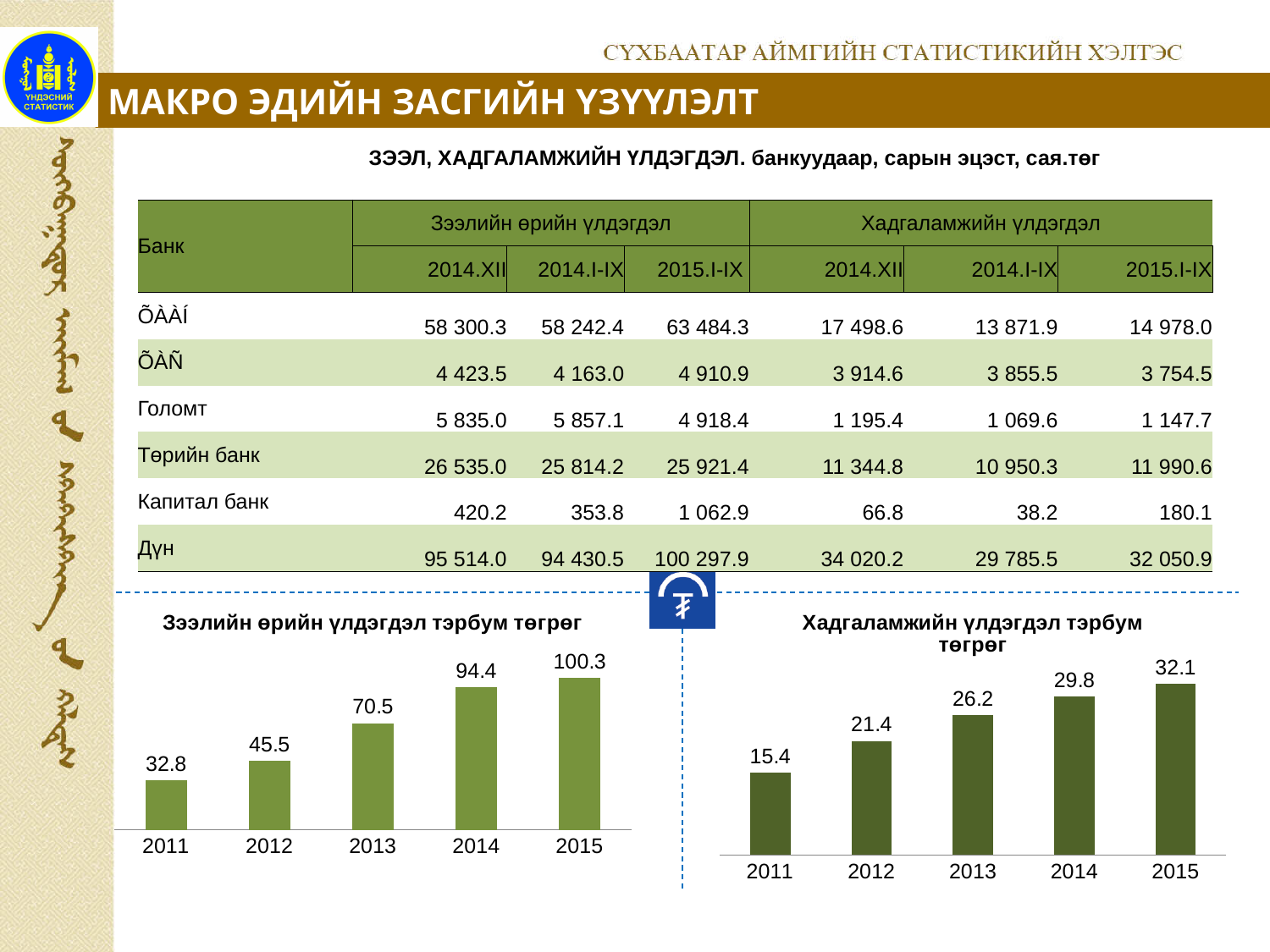
In the left chart titled "Зээлийн өрийн үлдэгдэл тэрбум төгрөг", which is larger, the value for 2012 or the value for 2013? 2013 In the left chart titled "Зээлийн өрийн үлдэгдэл тэрбум төгрөг", what is the difference between the values for 2015 and 2014? 5.9 In the left chart titled "Зээлийн өрийн үлдэгдэл тэрбум төгрөг", which year has the highest value? 2015 In the right chart titled "Хадгаламжийн үлдэгдэл тэрбум төгрөг", what is the value for 2014? 29.8 In the left chart titled "Зээлийн өрийн үлдэгдэл тэрбум төгрөг", what is the value for 2011? 32.8 How many years are shown on the x axis of the right chart titled "Хадгаламжийн үлдэгдэл тэрбум төгрөг"? 5 In the right chart titled "Хадгаламжийн үлдэгдэл тэрбум төгрөг", which year has the lowest value? 2011 What kind of chart is the left chart titled "Зээлийн өрийн үлдэгдэл тэрбум төгрөг"? Bar chart In the right chart titled "Хадгаламжийн үлдэгдэл тэрбум төгрөг", what is the difference between the values for 2013 and 2011? 10.8 In the right chart titled "Хадгаламжийн үлдэгдэл тэрбум төгрөг", what is the value for 2012? 21.4 In the right chart titled "Хадгаламжийн үлдэгдэл тэрбум төгрөг", do the values rise or fall from 2011 to 2015? Rise In the left chart titled "Зээлийн өрийн үлдэгдэл тэрбум төгрөг", what is the value for 2013? 70.5